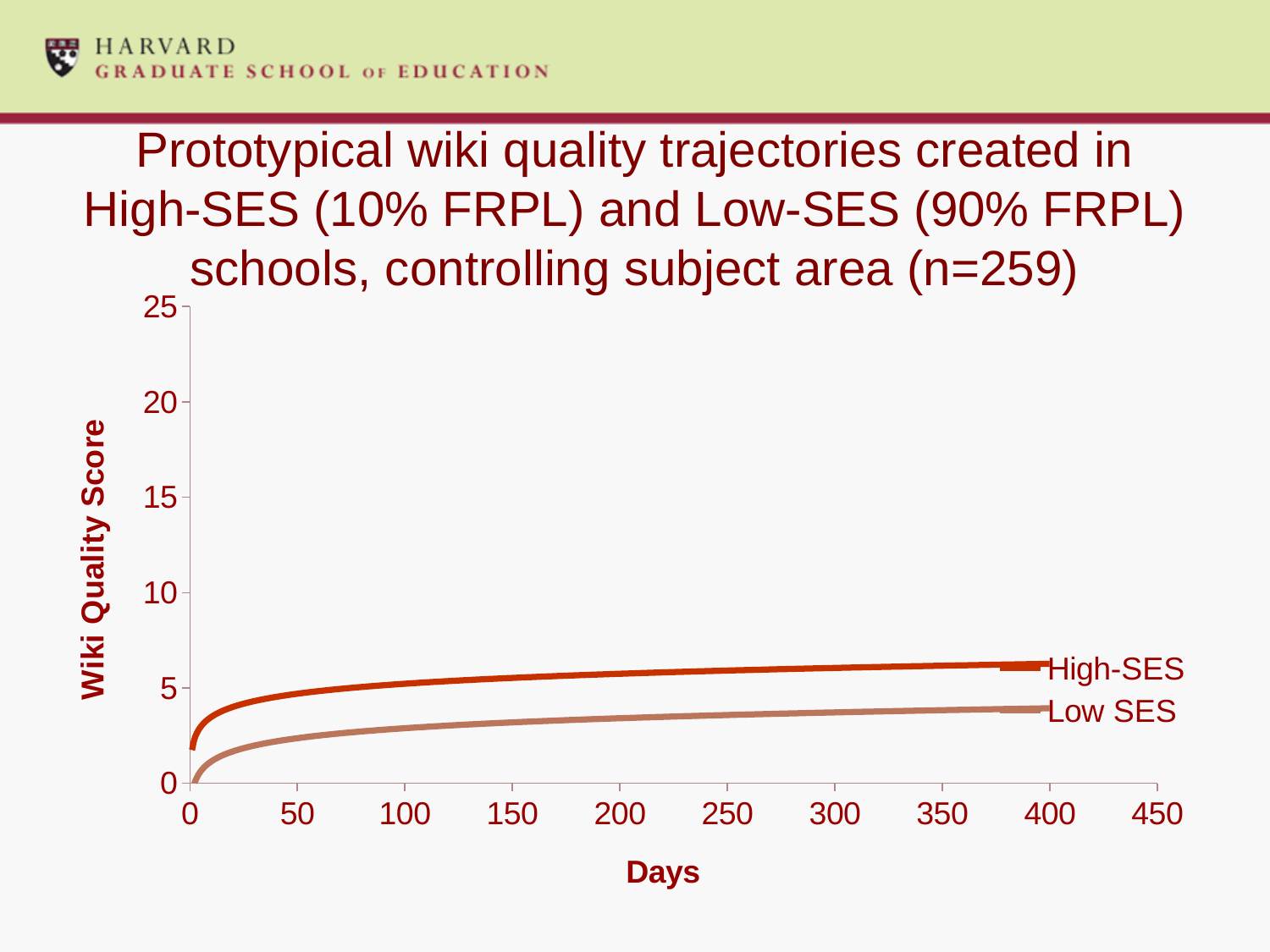
Is the Wiki Quality Score for High-SES at 400 days greater or less than 5? greater What kind of chart is shown on the slide? line chart Is the Wiki Quality Score for Low SES at 400 days greater or less than 5? less What is the label of the y axis? Wiki Quality Score Does the Wiki Quality Score for Low SES rise or fall as Days increase? rise Is the Wiki Quality Score for High-SES at 400 days greater or less than 10? less What is the label of the x axis? Days Which series has the higher Wiki Quality Score at 400 days, High-SES or Low SES? High-SES How many series are plotted on the chart? 2 Does the Wiki Quality Score for High-SES rise or fall as Days increase? rise Which series has the lower Wiki Quality Score throughout the chart? Low SES